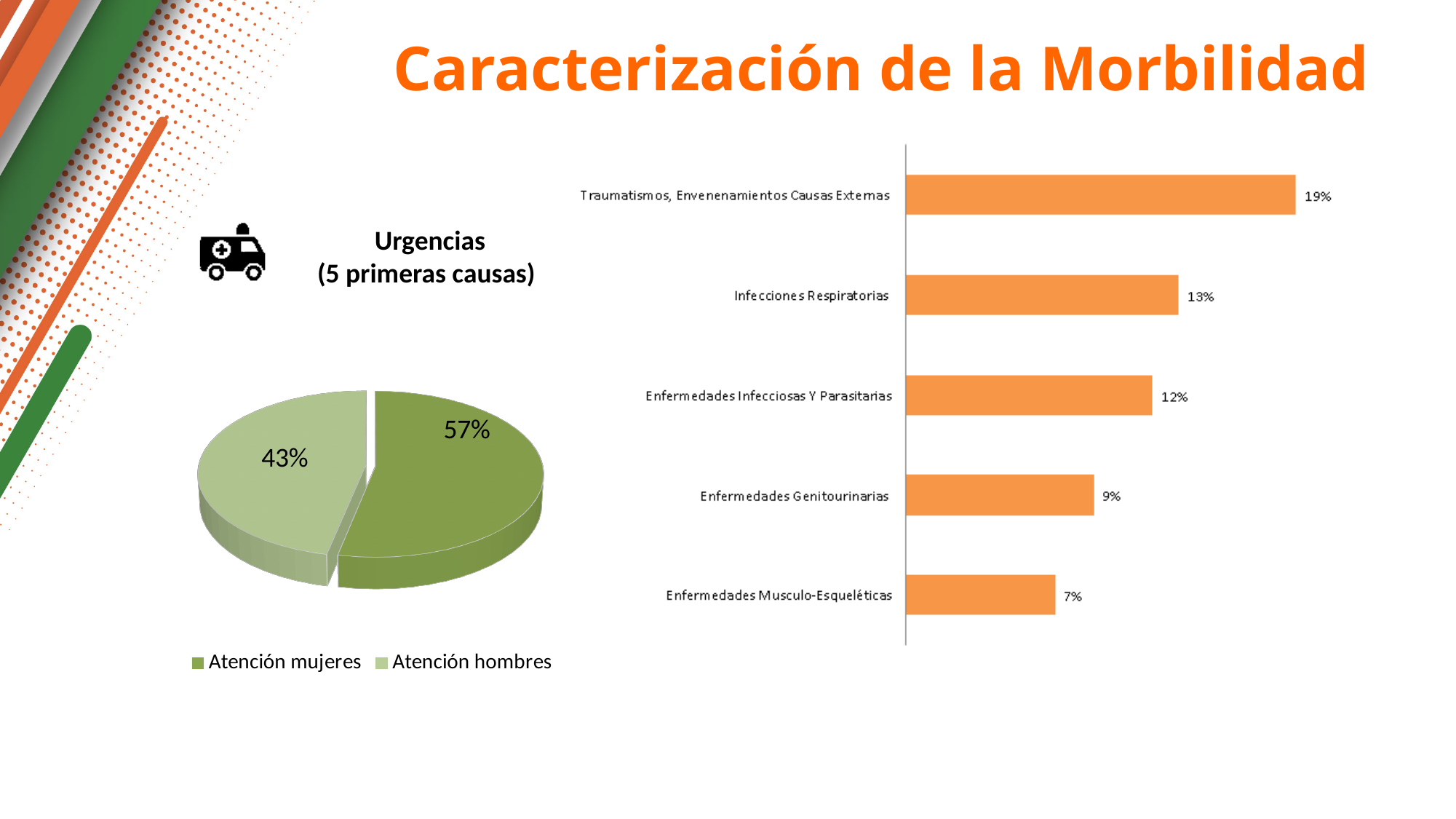
In the pie chart on the left, which slice is larger, Atención mujeres or Atención hombres? Atención mujeres What kind of chart is the chart on the right of the slide? Bar chart In the pie chart on the left, what share is shown for Atención mujeres? 57% In the bar chart on the right, what is the difference between Traumatismos, Envenenamientos Causas Externas and Enfermedades Infecciosas Y Parasitarias? 7% What kind of chart is the chart on the left of the slide? Pie chart In the bar chart on the right, which category has the lowest value? Enfermedades Musculo-Esqueléticas In the pie chart on the left, what share is shown for Atención hombres? 43% In the bar chart on the right, which category has the highest value? Traumatismos, Envenenamientos Causas Externas In the bar chart on the right, what is the value for Infecciones Respiratorias? 13% In the bar chart on the right, what is the value for Enfermedades Genitourinarias? 9% In the pie chart on the left, what is the difference between the Atención mujeres and Atención hombres shares? 14% How many entries does the legend of the pie chart on the left list? 2